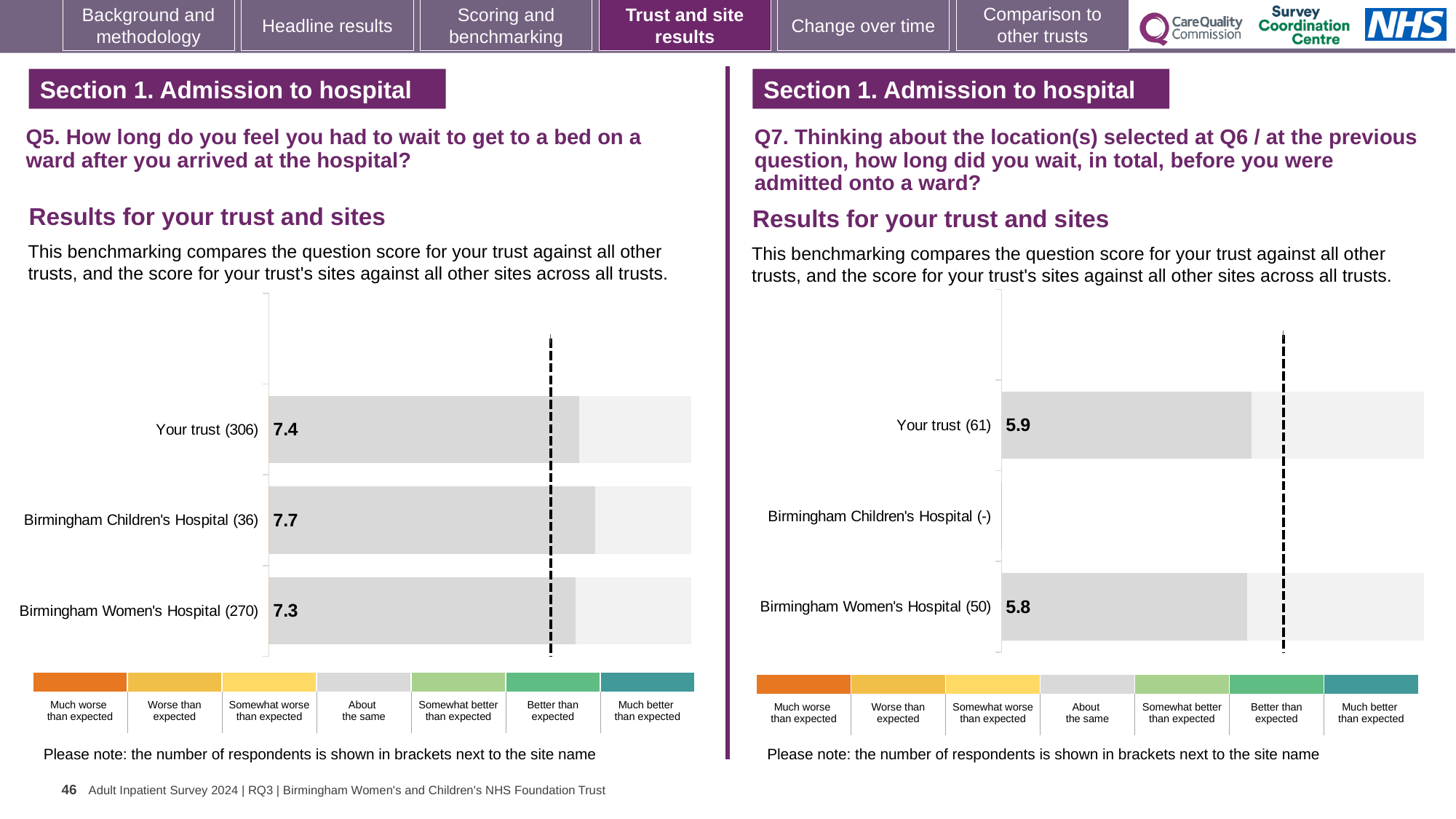
In the Q7 chart on the right, what is the score for Birmingham Women's Hospital? 5.8 In the Q7 chart on the right, what is the score for Your trust? 5.9 In the Q5 chart on the left, which site or trust has the highest score? Birmingham Children's Hospital In the Q7 chart on the right, which has the larger score, Your trust or Birmingham Women's Hospital? Your trust In the Q5 chart on the left, which site or trust has the lowest score? Birmingham Women's Hospital In the Q5 chart on the left, what is the score for Birmingham Children's Hospital? 7.7 In the Q7 chart on the right, how many respondents are shown for Your trust? 61 In the Q5 chart on the left, what is the score for Your trust? 7.4 What type of chart is used for the Q5 results on the left? Bar chart How many bars are plotted in the Q5 chart on the left? 3 In the Q5 chart on the left, what is the difference between the scores for Birmingham Children's Hospital and Birmingham Women's Hospital? 0.4 In the Q5 chart on the left, what is the score for Birmingham Women's Hospital? 7.3